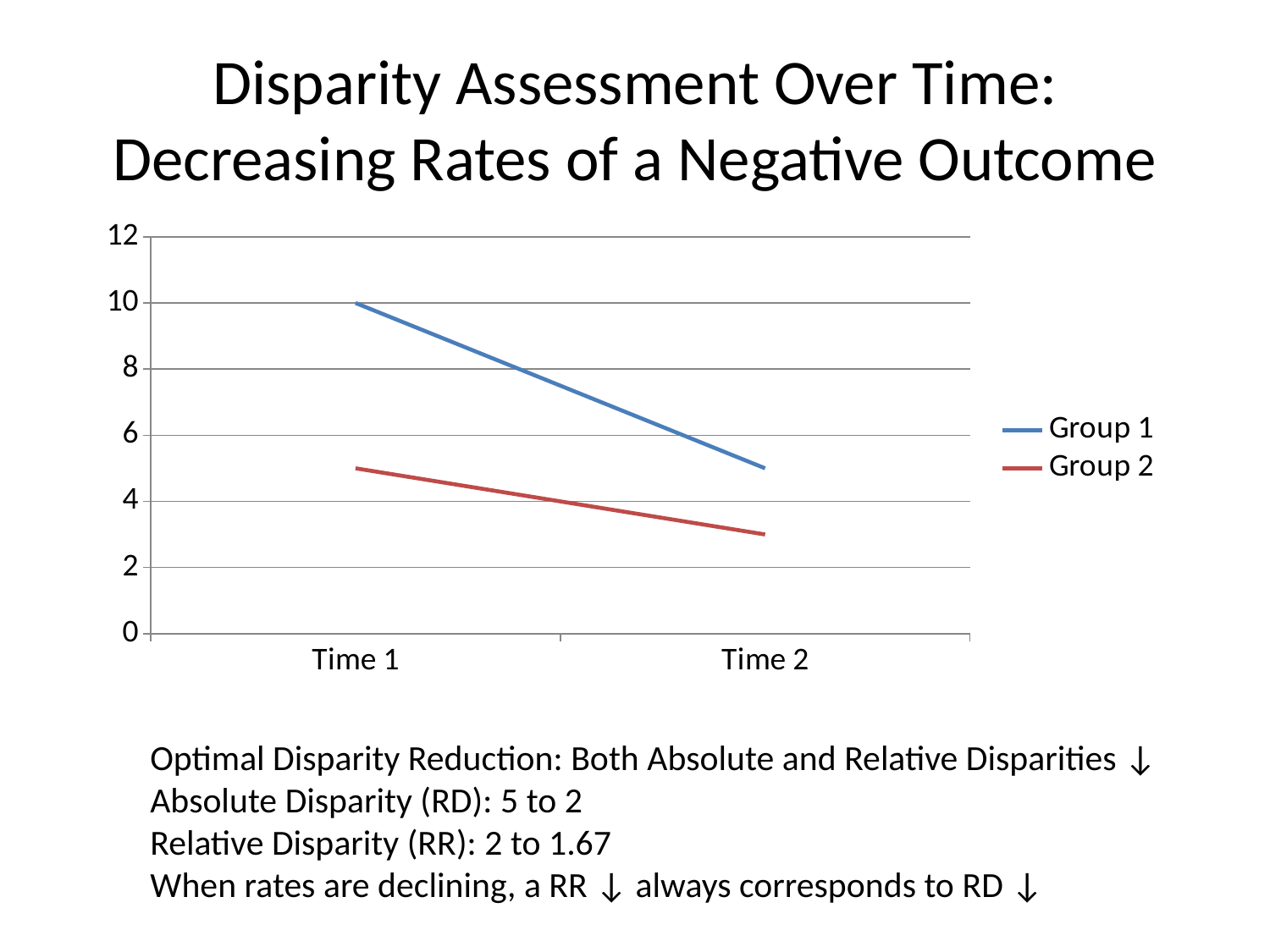
Is the value for Group 2 at Time 2 greater or less than 4? less Which series has the highest value at Time 2? Group 1 What is the value for Group 1 at Time 1? 10 What colour is the line for Group 2? red Is the value for Group 2 at Time 1 greater or less than 4? greater How many series does the legend list? 2 How many time points are shown on the x axis? 2 Does the value for Group 2 rise or fall from Time 1 to Time 2? fall At Time 1, which group has the higher value, Group 1 or Group 2? Group 1 What kind of chart is shown on the slide? line chart Does the value for Group 1 rise or fall from Time 1 to Time 2? fall Is the value for Group 1 at Time 2 greater or less than 8? less